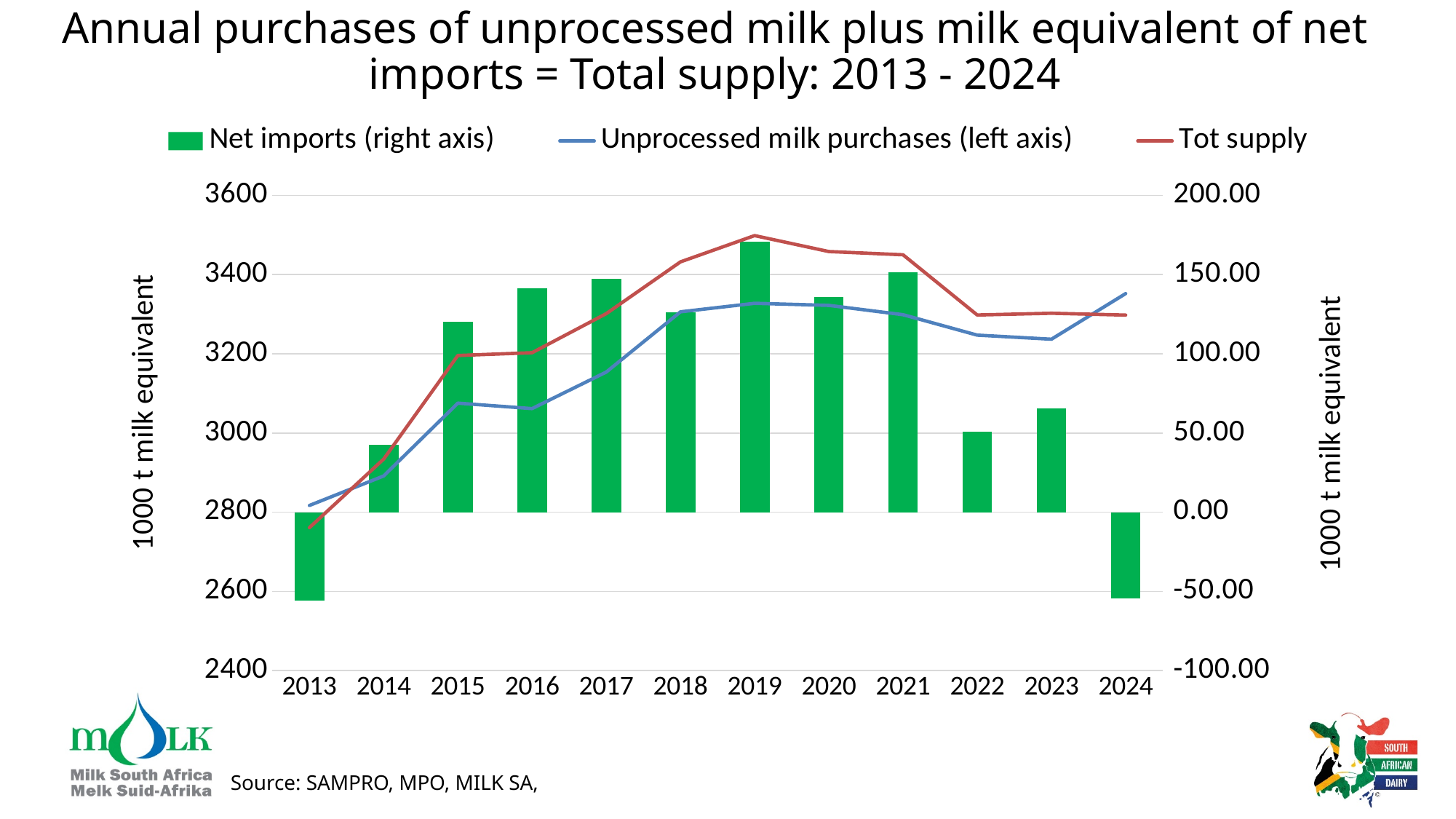
Does the Tot supply line rise or fall from 2013 to 2019? rise Which year has the larger Net imports value, 2019 or 2022? 2019 Is the Unprocessed milk purchases value for 2019 greater or less than 3200? greater Is the Unprocessed milk purchases value for 2013 greater or less than 3000? less Is the Net imports value for 2022 greater or less than 100.00? less In which year does the Tot supply line reach its peak? 2019 What kind of chart is shown on the slide? A combination bar and line chart How many years are shown on the x axis? 12 How many series does the legend list? 3 In which year is the Net imports bar highest? 2019